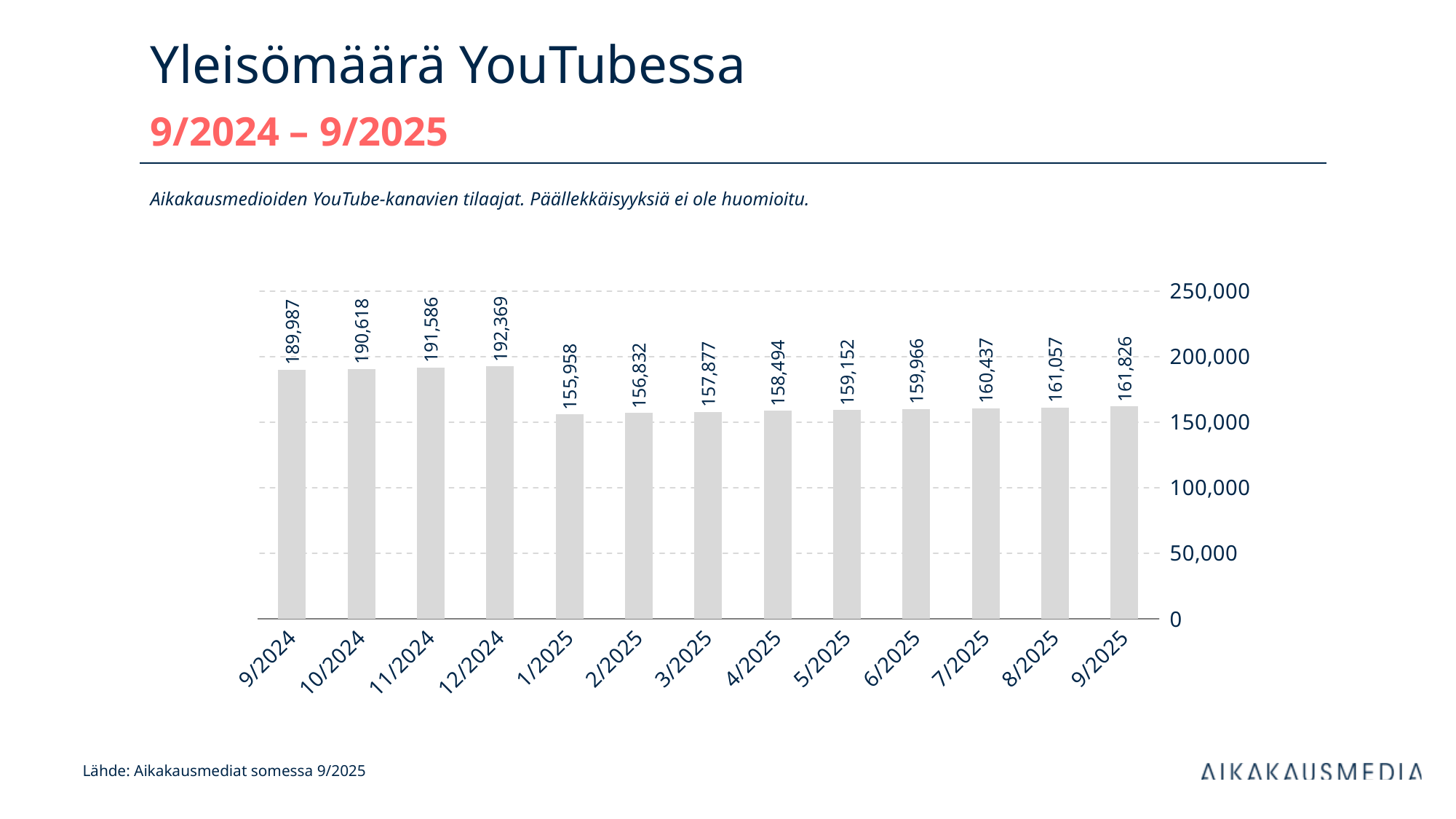
What is the value for 12/2024? 192,369 What is the value for 9/2025? 161,826 Which month has the highest value? 12/2024 Do the values rise or fall from 1/2025 to 9/2025? rise Is the value for 11/2024 greater or less than 150,000? greater Which month has the lowest value? 1/2025 Which is larger, the value for 9/2024 or the value for 9/2025? 9/2024 What kind of chart is shown on the slide? bar chart What is the title of the chart on the slide? Yleisömäärä YouTubessa How many months are shown on the x axis? 13 What is the value for 1/2025? 155,958 What is the difference between the values for 12/2024 and 1/2025? 36,411